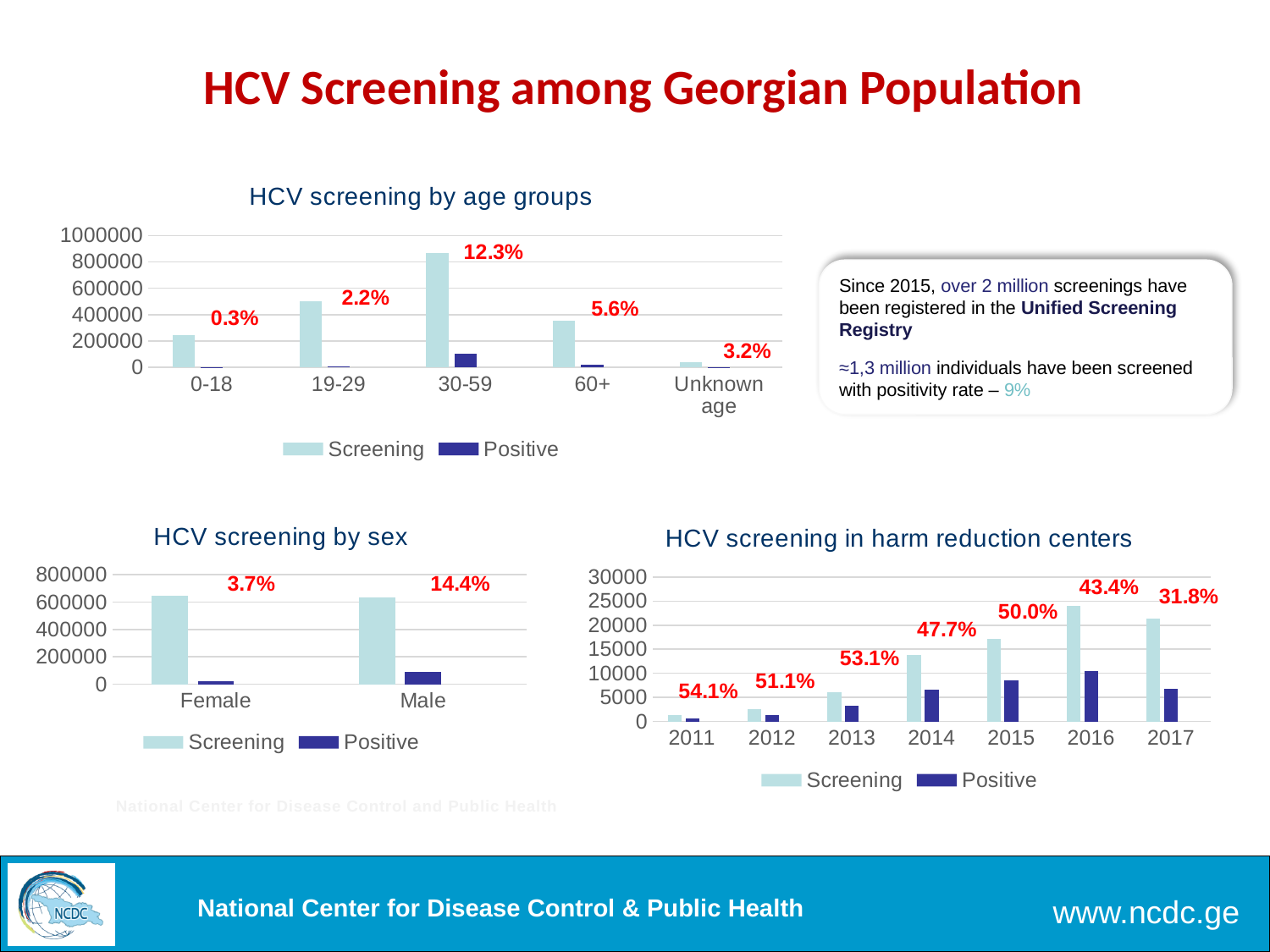
In the 'HCV screening by age groups' chart, what percentage label is shown for the 30-59 age group? 12.3% In the 'HCV screening in harm reduction centers' chart, what percentage label is shown for 2017? 31.8% In the 'HCV screening by sex' chart, which has the larger Positive bar, Female or Male? Male In the 'HCV screening in harm reduction centers' chart, is the Screening bar for 2015 greater or less than 15000? greater In the 'HCV screening by age groups' chart, is the Screening bar for 30-59 greater or less than 800000? greater In the 'HCV screening by age groups' chart, how many age group categories are shown on the x axis? 5 In the 'HCV screening by age groups' chart, which age group has the highest percentage label? 30-59 In the 'HCV screening by sex' chart, what percentage label is shown for Male? 14.4% How many series does the legend of the 'HCV screening in harm reduction centers' chart list? 2 In the 'HCV screening by sex' chart, what is the difference between the Male and Female percentage labels? 10.7 percentage points In the 'HCV screening by age groups' chart, which age group has the lowest percentage label? 0-18 In the 'HCV screening in harm reduction centers' chart, which year has the tallest Screening bar? 2016